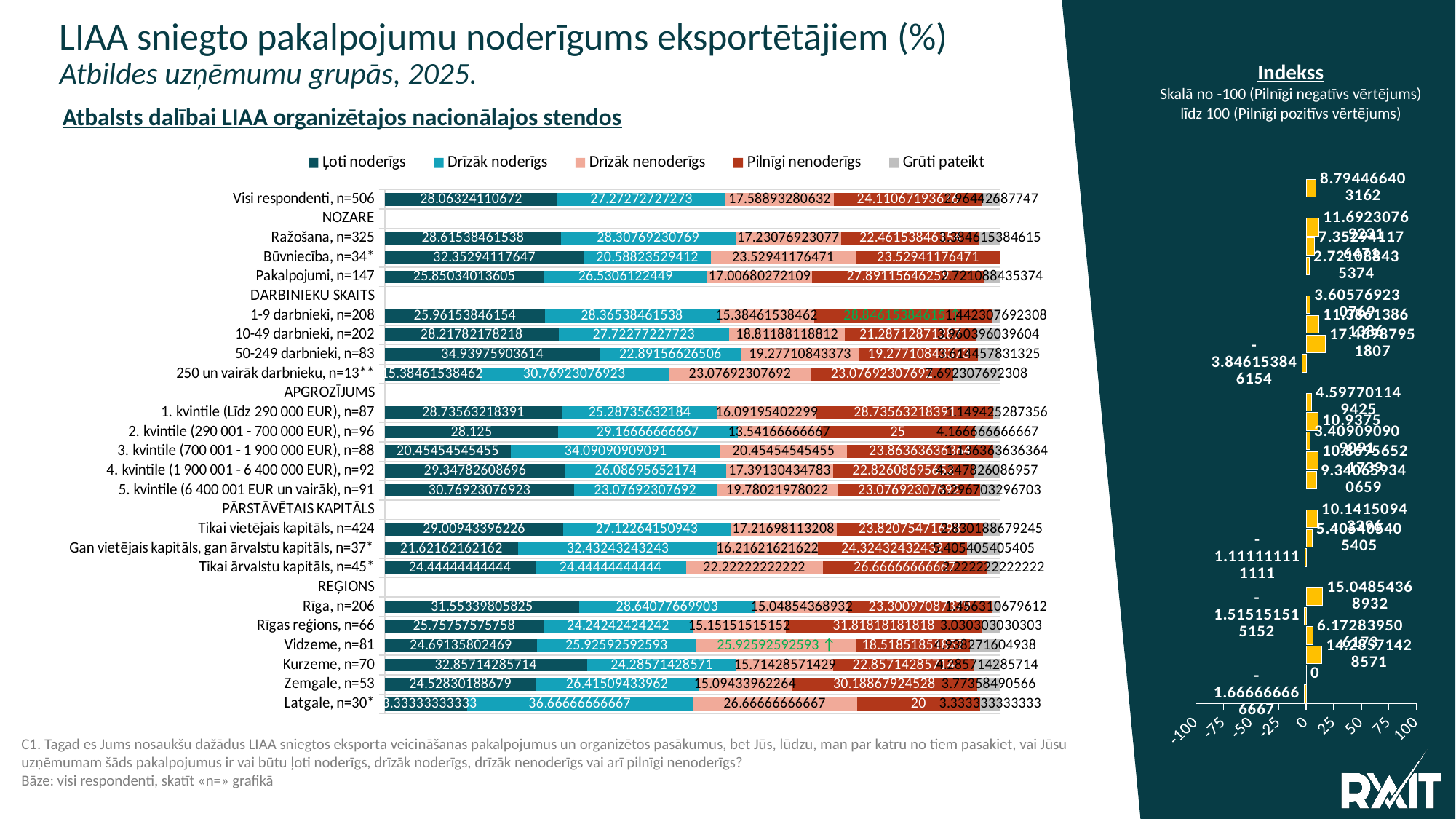
In the main chart, what is the 'Pilnīgi nenoderīgs' value for 2. kvintile (290 001 - 700 000 EUR), n=96? 25 In the main chart, which group has the highest 'Ļoti noderīgs' value? 50-249 darbnieki, n=83 In the main chart, what is the 'Ļoti noderīgs' value for Būvniecība, n=34*? 32.35294117647 In the main chart, which has the larger 'Pilnīgi nenoderīgs' value: Rīga, n=206 or Rīgas reģions, n=66? Rīgas reģions, n=66 In the main chart, what is the 'Drīzāk noderīgs' value for Latgale, n=30*? 36.66666666667 In the main chart, what is the 'Drīzāk nenoderīgs' value for Vidzeme, n=81? 25.92592592593 In the main chart, what is the difference between the 'Drīzāk nenoderīgs' and 'Pilnīgi nenoderīgs' values for Latgale, n=30*? 6.66666666667 In the main chart, which group has the lowest 'Ļoti noderīgs' value? Latgale, n=30* How many series does the legend of the main chart list? 5 What is the first series listed in the legend of the main chart? Ļoti noderīgs In the main chart, what is the 'Grūti pateikt' value for 250 un vairāk darbinieku, n=13**? 7.692307692308 What kind of chart is used for 'Atbalsts dalībai LIAA organizētajos nacionālajos stendos'? bar chart